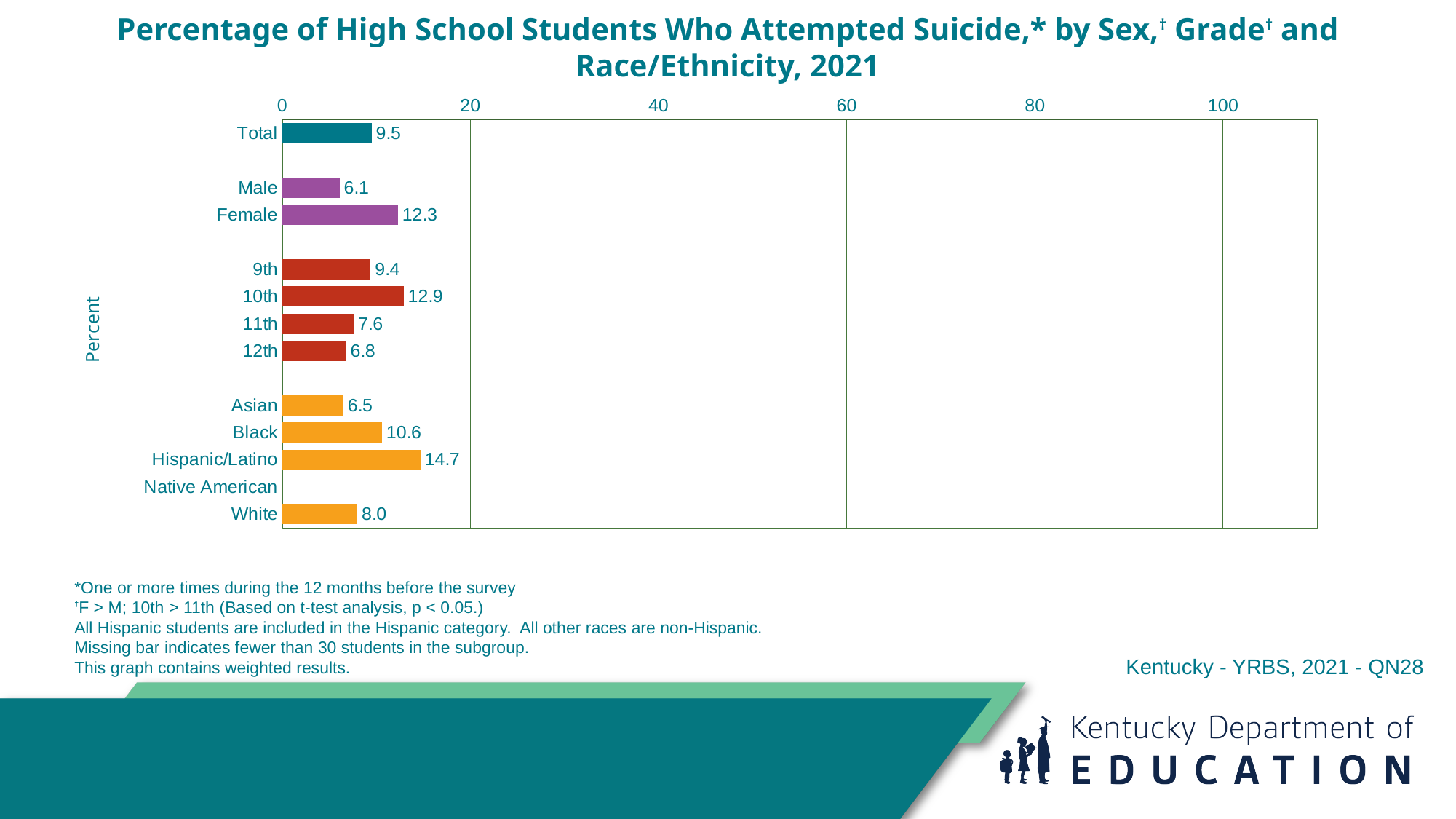
Is the value for Hispanic/Latino greater or less than 20? less What is the value for Total? 9.5 How many categories are labelled on the vertical axis? 12 What is the value for 10th grade? 12.9 What is the value for Hispanic/Latino? 14.7 Which category has no bar shown? Native American What is the difference between the Female and Male values? 6.2 Which grade has the lowest value? 12th What kind of chart is shown on the slide? bar chart Which is larger, the value for Black or the value for White? Black Which category has the highest value on the chart? Hispanic/Latino What is the value for Female? 12.3